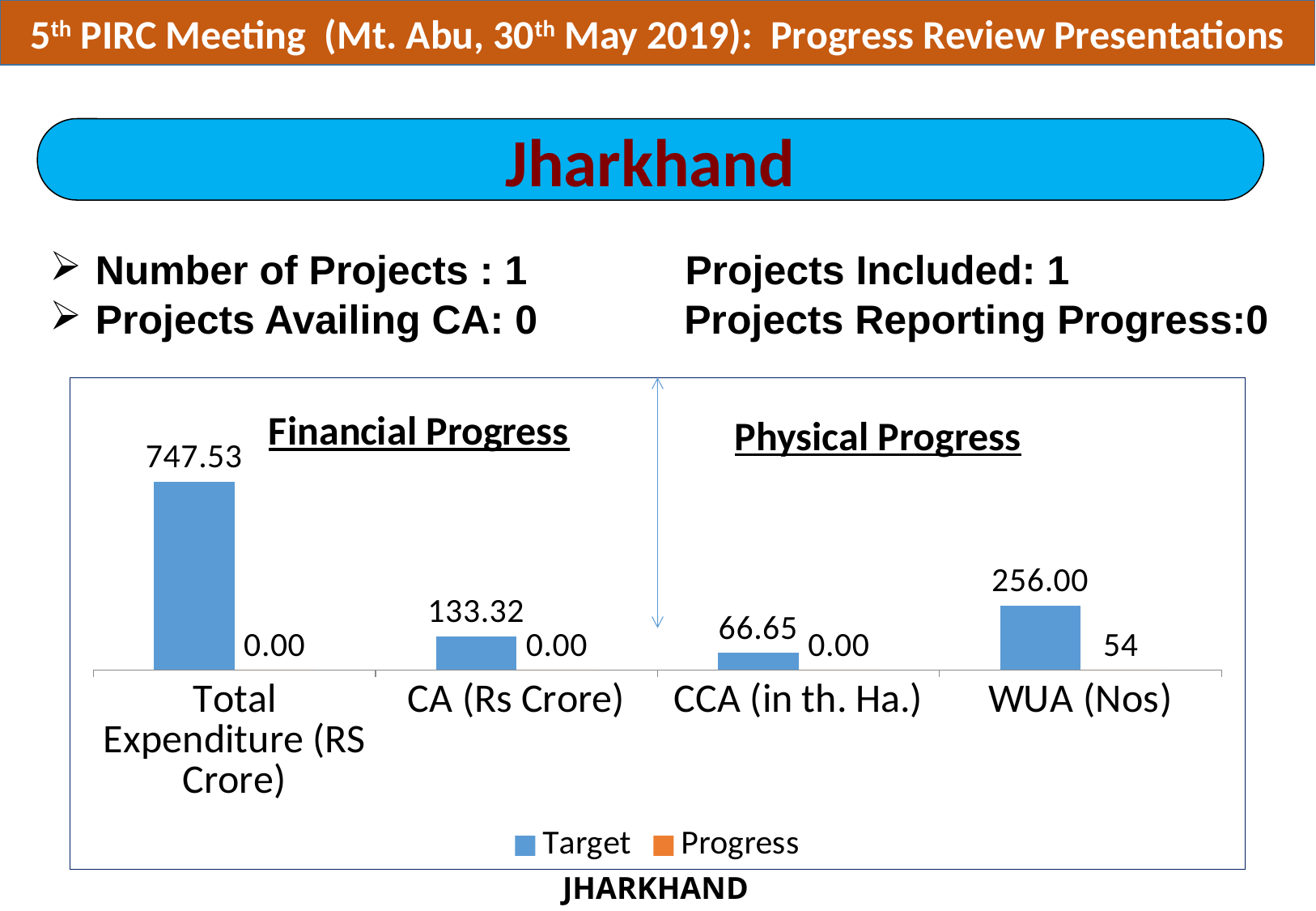
What is the difference between the Target and Progress values for WUA (Nos)? 202.00 What is the Progress value for CA (Rs Crore)? 0.00 How many categories are shown on the x axis of the chart? 4 Which is larger, the Target value for CA (Rs Crore) or the Target value for WUA (Nos)? WUA (Nos) What is the Target value for CCA (in th. Ha.)? 66.65 Which category has the highest Target value? Total Expenditure (RS Crore) What is the Progress value for WUA (Nos)? 54 What kind of chart is shown on the slide? Bar chart What is the Target value for Total Expenditure (RS Crore)? 747.53 How many series does the chart legend list? 2 Which category has the lowest Target value? CCA (in th. Ha.) What is the Target value for CA (Rs Crore)? 133.32